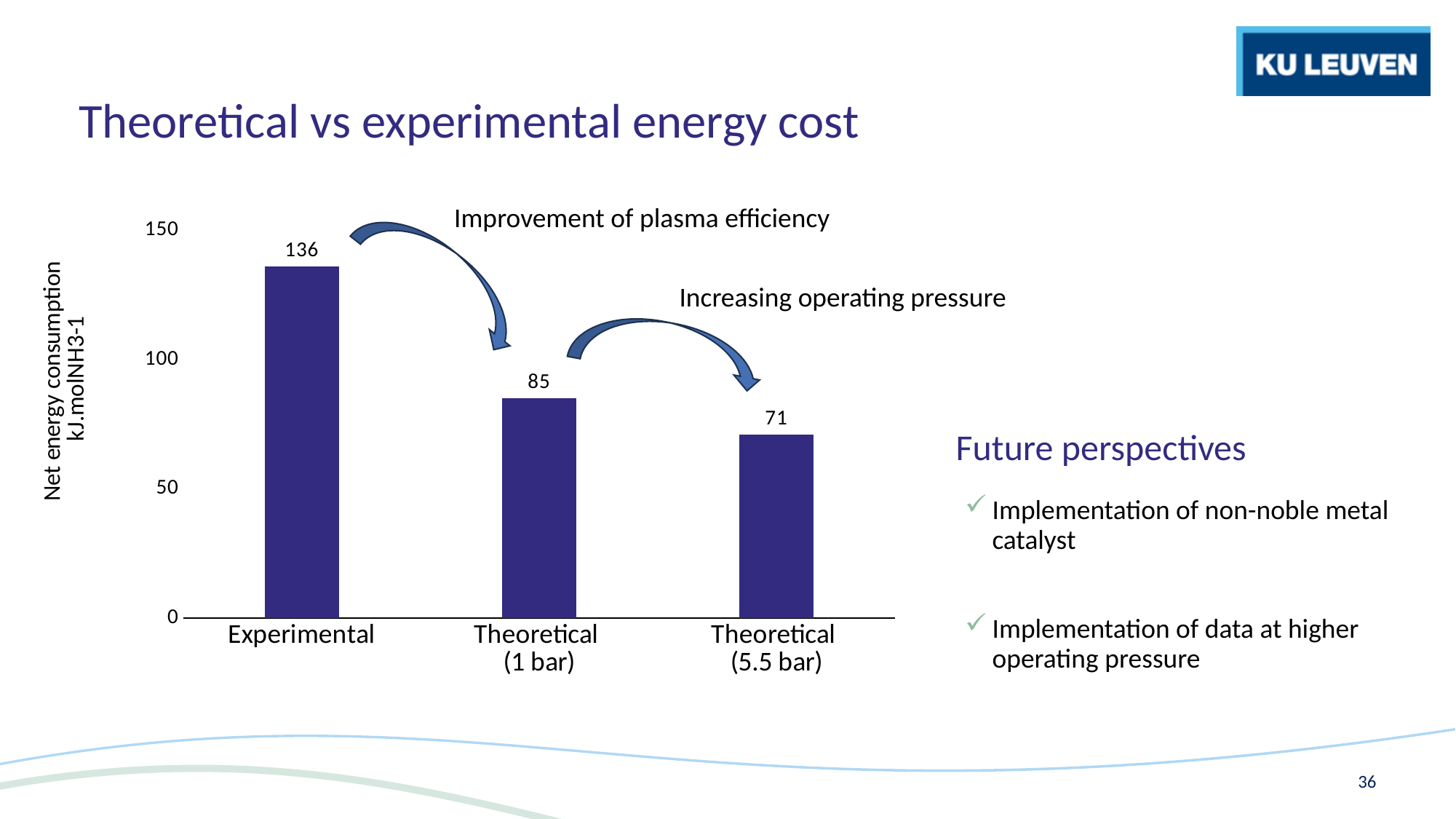
What is the net energy consumption for Theoretical (5.5 bar)? 71 Which is larger, the value for Experimental or the value for Theoretical (5.5 bar)? Experimental Do the values rise or fall from left to right along the x axis? fall What is the difference in net energy consumption between Theoretical (1 bar) and Theoretical (5.5 bar)? 14 How many categories are shown on the x axis? 3 Is the value for Theoretical (1 bar) greater or less than 100? less What is the net energy consumption for the Experimental case? 136 Which category has the highest net energy consumption? Experimental What is the difference in net energy consumption between Experimental and Theoretical (1 bar)? 51 What kind of chart is shown on the slide? bar chart What is the net energy consumption for Theoretical (1 bar)? 85 Which category has the lowest net energy consumption? Theoretical (5.5 bar)